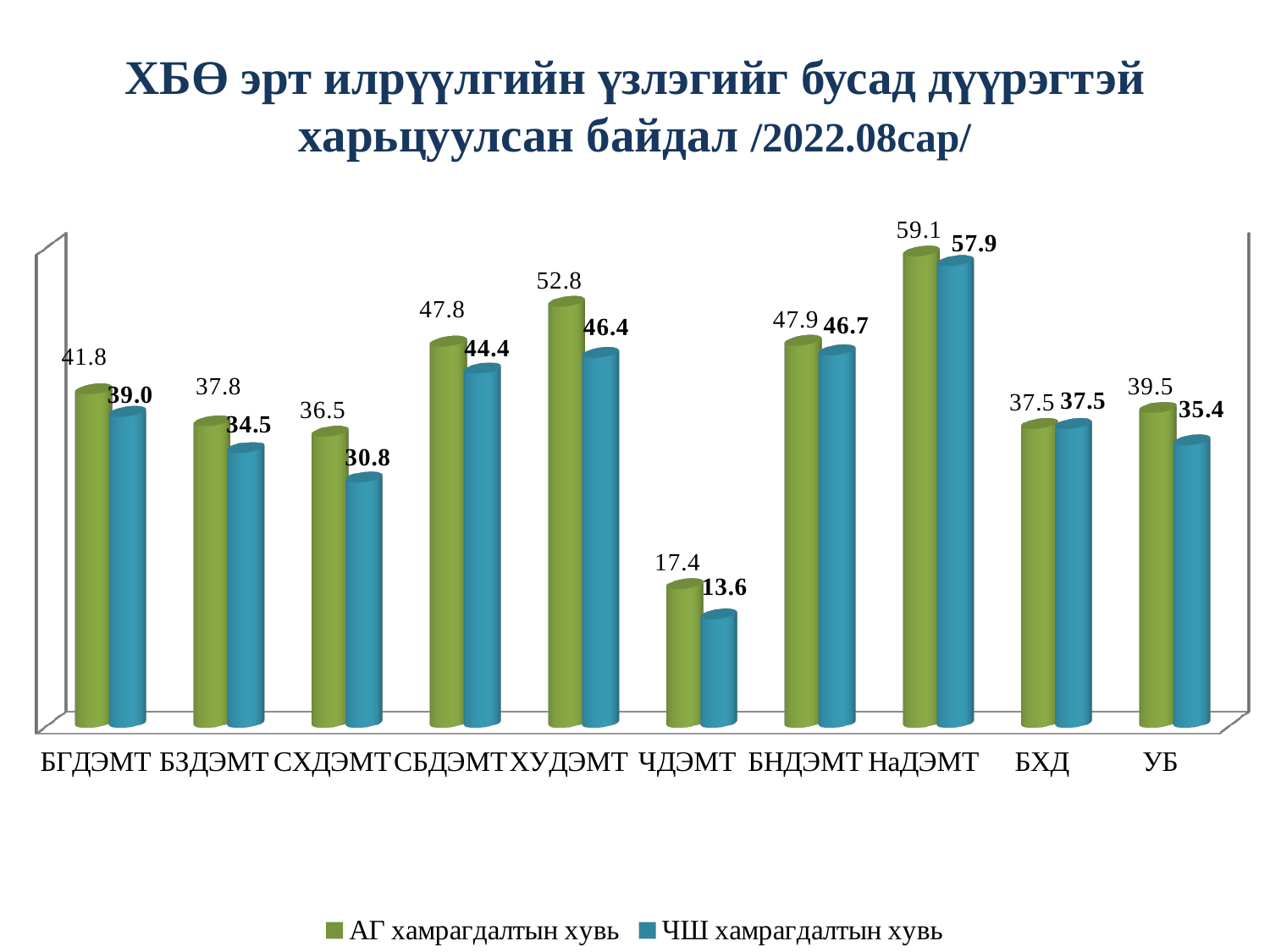
What type of chart is shown on the slide? bar chart What is the value of ЧШ хамрагдалтын хувь for СХДЭМТ? 30.8 Which category has the lowest value for ЧШ хамрагдалтын хувь? ЧДЭМТ What is the difference between АГ хамрагдалтын хувь and ЧШ хамрагдалтын хувь for СХДЭМТ? 5.7 What is the value of ЧШ хамрагдалтын хувь for УБ? 35.4 How many series does the legend list? 2 How many categories are shown on the x axis? 10 What is the difference between the АГ хамрагдалтын хувь values for НаДЭМТ and ЧДЭМТ? 41.7 Which is larger for БНДЭМТ: АГ хамрагдалтын хувь or ЧШ хамрагдалтын хувь? АГ хамрагдалтын хувь Which colour represents ЧШ хамрагдалтын хувь in the chart? blue What is the value of АГ хамрагдалтын хувь for ХУДЭМТ? 52.8 Which category has the highest value for АГ хамрагдалтын хувь? НаДЭМТ